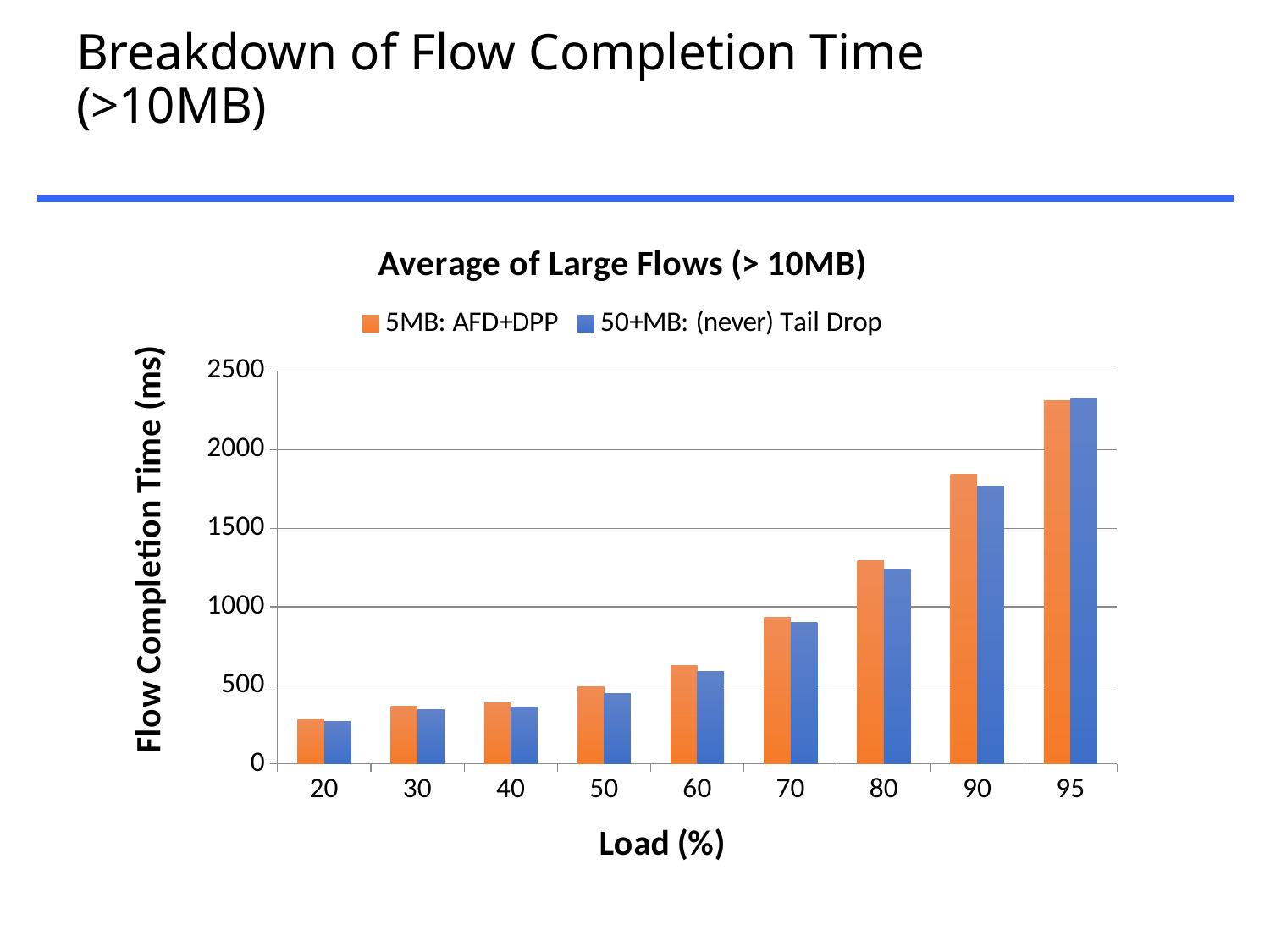
How many series does the legend list? 2 At which load is the flow completion time for 5MB: AFD+DPP highest? 95 Is the value for 50+MB: (never) Tail Drop at load 20 greater or less than 500? less Is the value for 5MB: AFD+DPP at load 80 greater or less than 1000? greater How many load categories are shown on the x axis? 9 Is the value for 5MB: AFD+DPP at load 95 greater or less than 2000? greater At load 90, which series has the larger flow completion time? 5MB: AFD+DPP What type of chart is shown on the slide? bar chart Do the flow completion times rise or fall as load increases from 20 to 95? rise What is the title of the chart? Average of Large Flows (> 10MB) At which load is the flow completion time for 50+MB: (never) Tail Drop lowest? 20